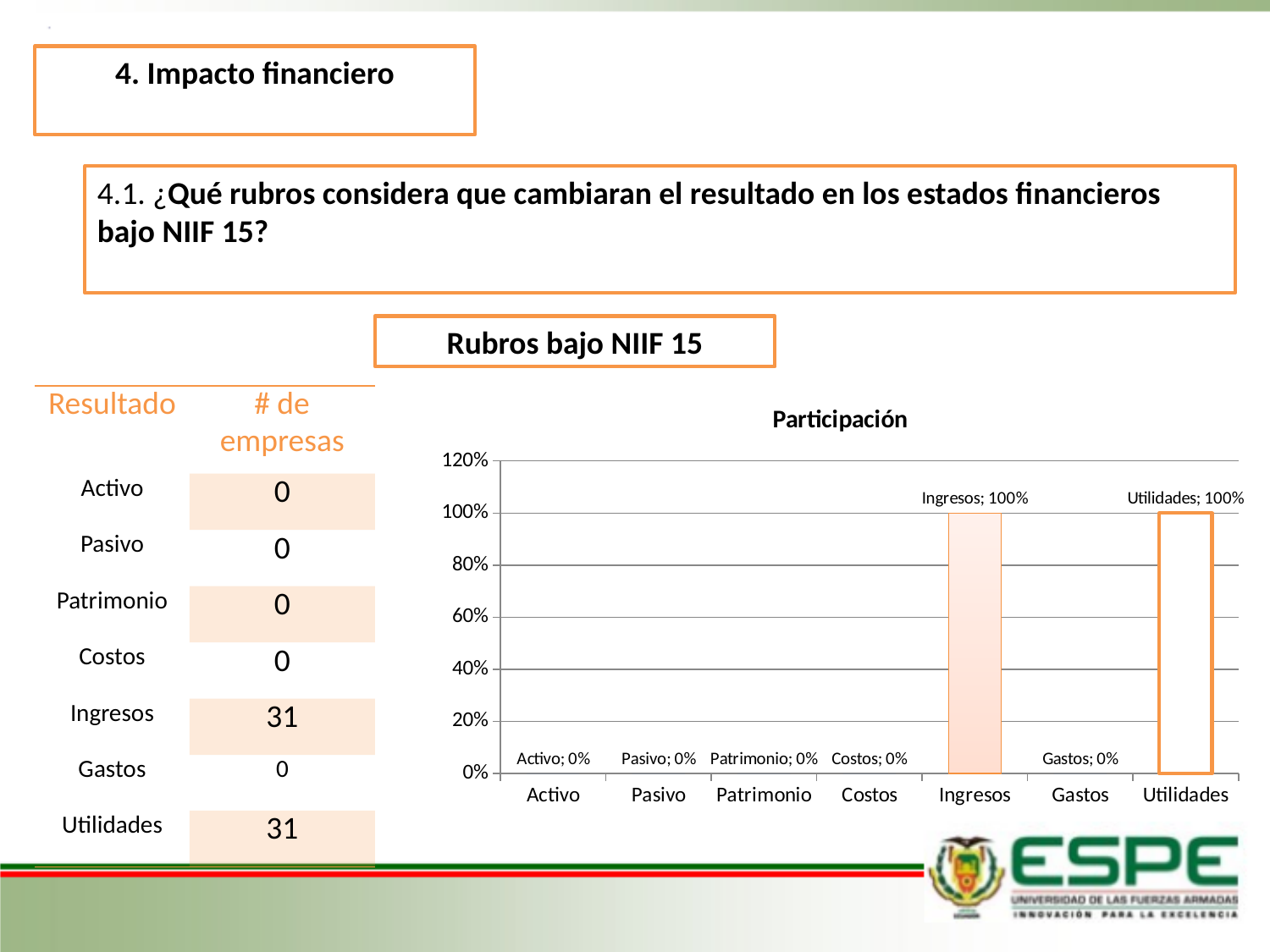
What is the highest value shown on the y axis of the Participación chart? 120% Is the value for Ingresos in the Participación chart greater or less than 80%? greater How many categories are shown on the x axis of the Participación chart? 7 What is the value for Ingresos in the Participación chart? 100% What is the value for Patrimonio in the Participación chart? 0% What is the value for Gastos in the Participación chart? 0% How many categories in the Participación chart have a value of 0%? 5 What kind of chart is the Participación chart? bar chart Which is larger in the Participación chart, the value for Ingresos or the value for Costos? Ingresos What is the title of the chart on the slide? Participación What is the value for Utilidades in the Participación chart? 100% What is the difference between the values for Utilidades and Gastos in the Participación chart? 100%